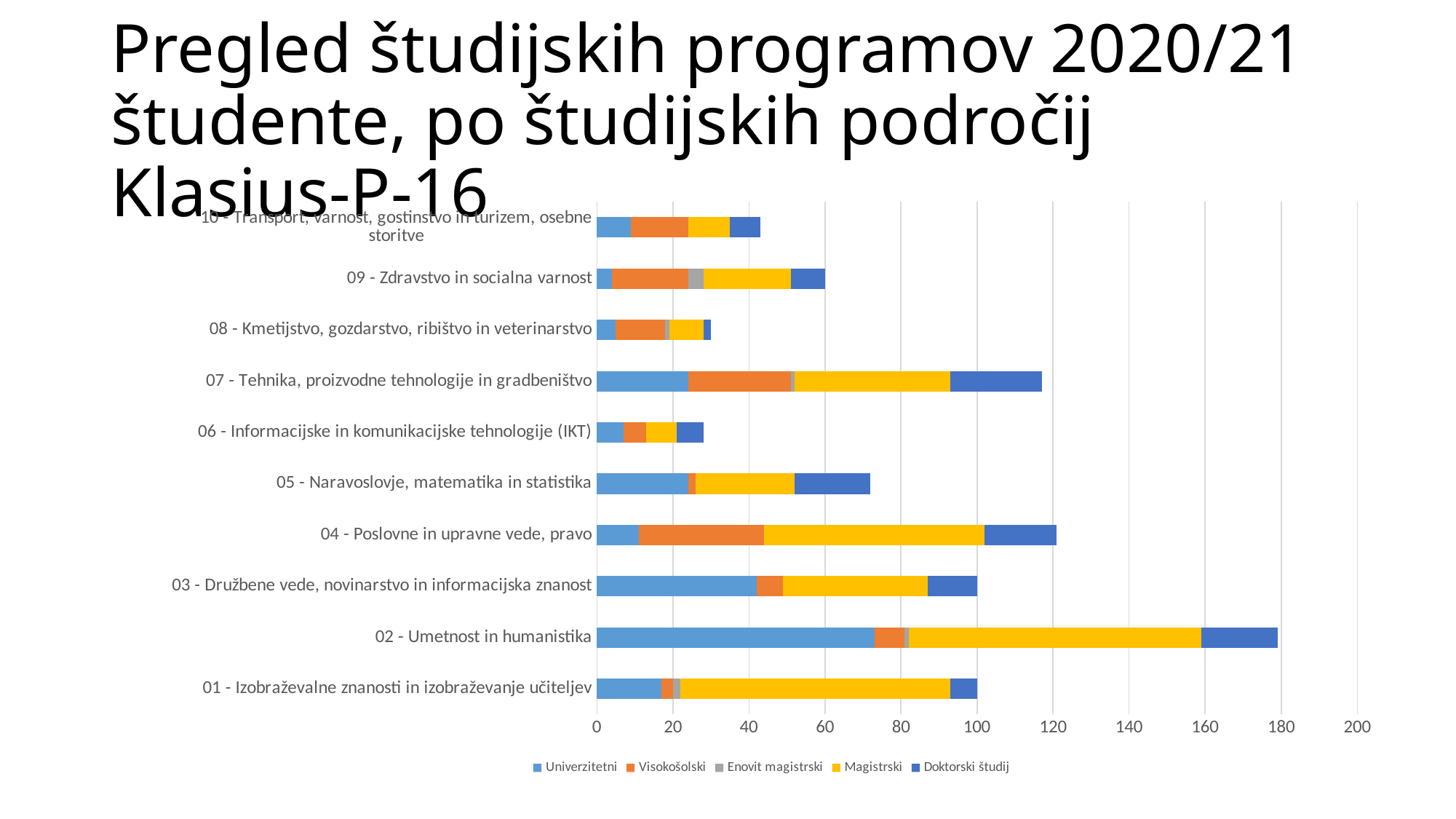
Is the total bar for 05 - Naravoslovje, matematika in statistika greater or less than 80? less Is the total bar for 02 - Umetnost in humanistika greater or less than 160? greater How many series does the legend list? 5 Which series is shown in yellow in the legend? Magistrski Which category has the longest total bar? 02 - Umetnost in humanistika Which has the longer total bar: 07 - Tehnika, proizvodne tehnologije in gradbeništvo or 05 - Naravoslovje, matematika in statistika? 07 - Tehnika, proizvodne tehnologije in gradbeništvo Is the total bar for 07 - Tehnika, proizvodne tehnologije in gradbeništvo greater or less than 100? greater What kind of chart is shown on the slide? Stacked bar chart How many study field categories are plotted on the chart? 10 Which has the longer total bar: 02 - Umetnost in humanistika or 04 - Poslovne in upravne vede, pravo? 02 - Umetnost in humanistika